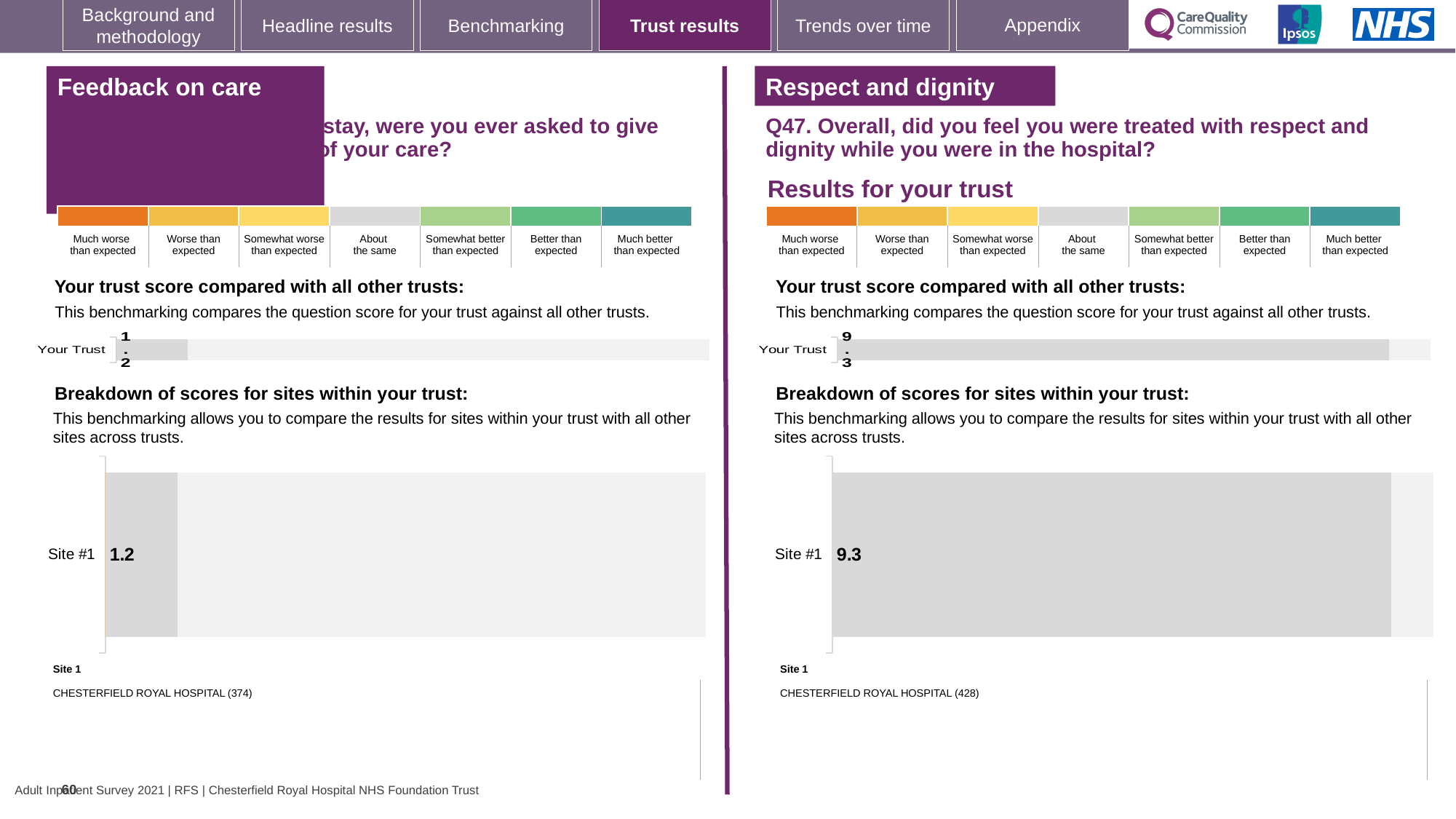
What kind of chart is used to show the Site #1 score in the 'Respect and dignity' section? Bar chart Which section's Site #1 bar shows the larger value: 'Feedback on care' or 'Respect and dignity'? Respect and dignity In the 'Respect and dignity' breakdown of scores for sites chart, what is the value for Site #1? 9.3 In the 'Feedback on care' breakdown of scores for sites chart, what is the value for Site #1? 1.2 Which hospital is listed as Site 1 beneath the 'Respect and dignity' breakdown chart? CHESTERFIELD ROYAL HOSPITAL What number appears in parentheses after the Site 1 hospital name beneath the 'Feedback on care' breakdown chart? 374 In the 'Respect and dignity' section, what is the score shown for 'Your Trust' in the chart comparing the trust score with all other trusts? 9.3 What is the difference between the Site #1 value in the 'Respect and dignity' chart and the Site #1 value in the 'Feedback on care' chart? 8.1 How many sites are shown in the 'Feedback on care' breakdown of scores for sites chart? 1 Is the 'Your Trust' value in the 'Feedback on care' section greater or less than the 'Your Trust' value in the 'Respect and dignity' section? less In the 'Feedback on care' section, what is the score shown for 'Your Trust' in the chart comparing the trust score with all other trusts? 1.2